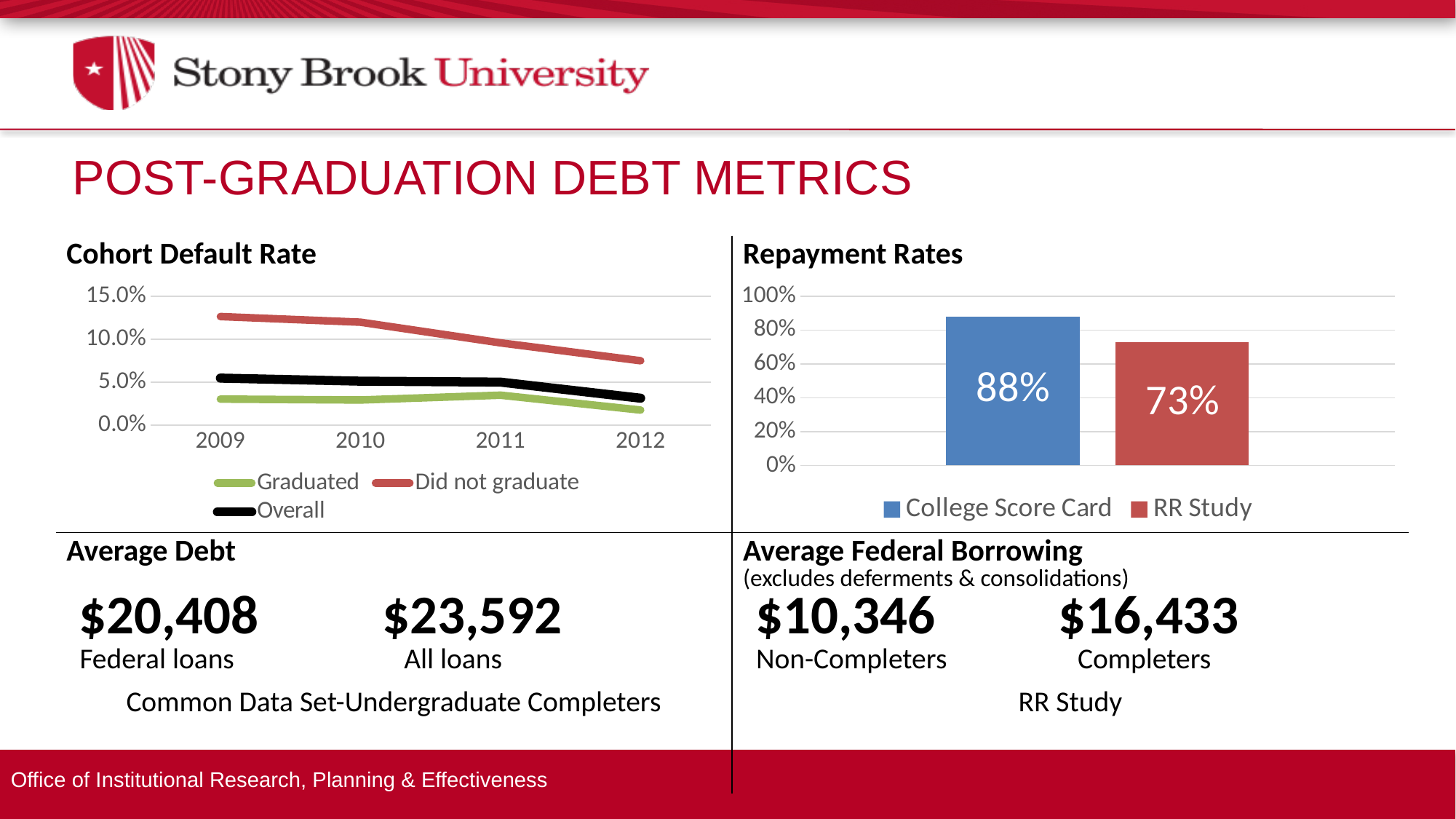
What kind of chart is the Cohort Default Rate chart? Line chart In the Repayment Rates chart, what is the difference between the College Score Card and RR Study values? 15% In the Repayment Rates chart, which series has the higher repayment rate? College Score Card In the Repayment Rates chart, what is the value for College Score Card? 88% What kind of chart is the Repayment Rates chart? Bar chart In the Cohort Default Rate chart, does the Did not graduate line rise or fall from 2009 to 2012? Fall In the Cohort Default Rate chart, how many series does the legend list? 3 In the Repayment Rates chart, what is the value for RR Study? 73% In the Cohort Default Rate chart, how many years are shown on the x axis? 4 In the Repayment Rates chart, how many series does the legend list? 2 In the Cohort Default Rate chart, is the Did not graduate value for 2009 greater or less than 10.0%? greater In the Cohort Default Rate chart, which series has the highest default rate in 2012? Did not graduate